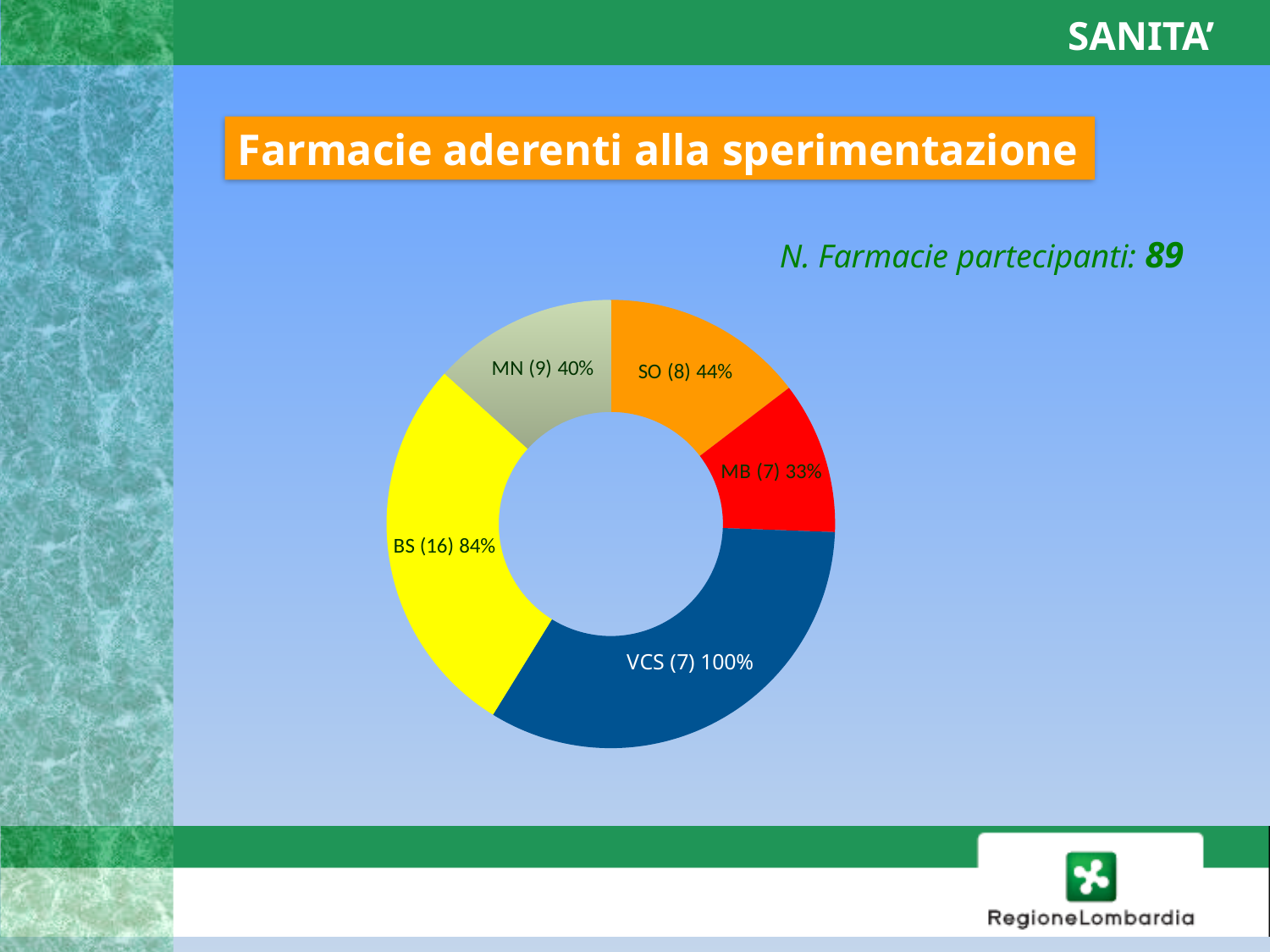
What colour is the VCS slice? Dark blue How many pharmacies are shown in parentheses for MN? 9 What percentage is shown for SO? 44% What kind of chart is shown on the slide? Doughnut (pie) chart What percentage is shown for VCS? 100% Which category shows the lowest percentage? MB What is the label shown for the BS slice? BS (16) 84% How many categories (slices) does the chart show? 5 Which category shows the highest percentage? VCS What is the difference between the number of pharmacies for BS and for MN? 7 Which has a higher percentage, SO or MN? SO Which category has the highest number of pharmacies in parentheses? BS